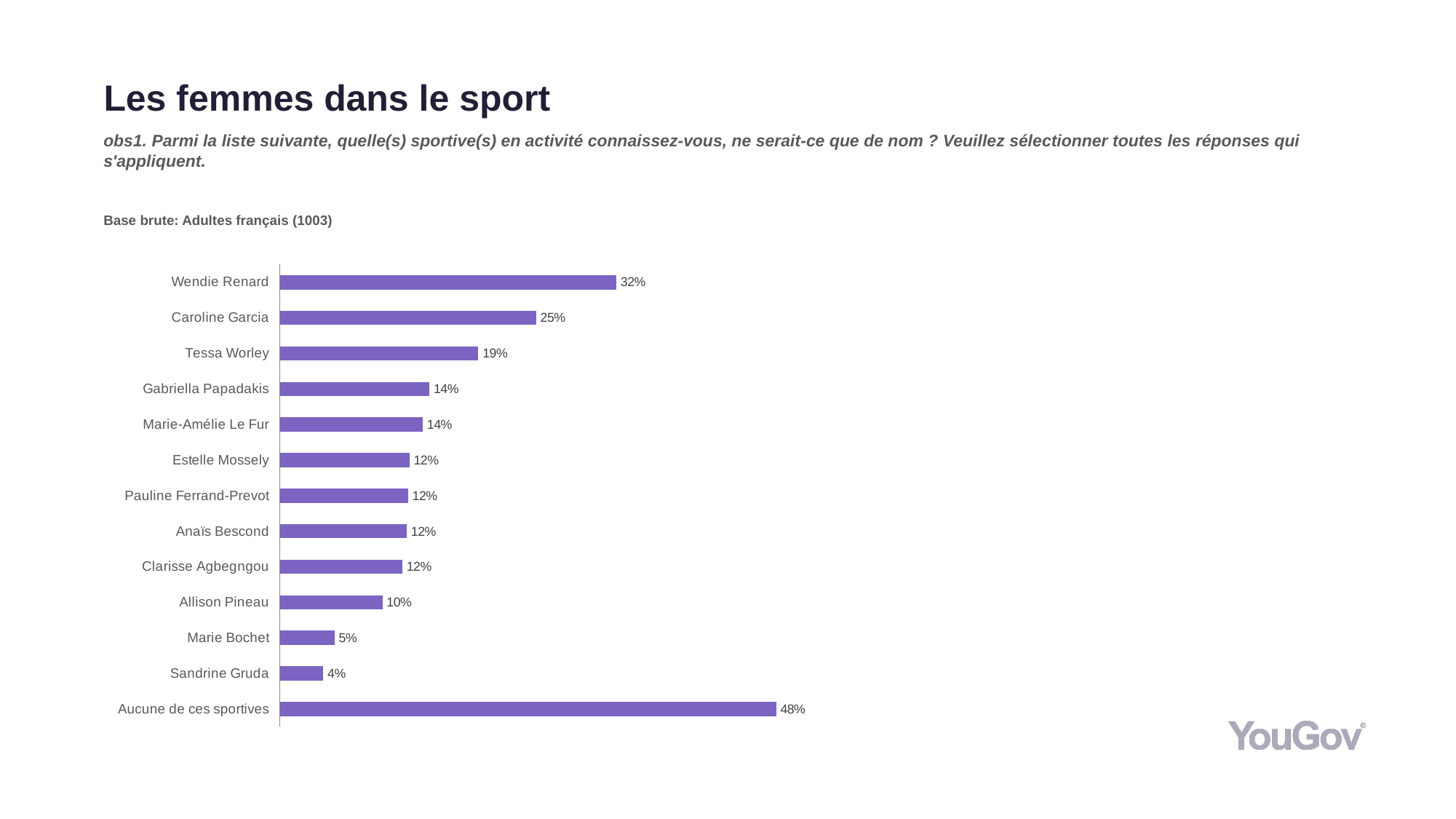
How many categories are shown in the chart? 13 Which category has the lowest value? Sandrine Gruda What kind of chart is shown on the slide? Bar chart Which category has the highest value? Aucune de ces sportives What is the difference between the values for Wendie Renard and Caroline Garcia? 7% What is the value for Aucune de ces sportives? 48% What is the value for Wendie Renard? 32% What is the value for Tessa Worley? 19% Which is larger, the value for Marie Bochet or the value for Sandrine Gruda? Marie Bochet What is the title of the slide? Les femmes dans le sport What is the value for Caroline Garcia? 25% What is the value for Allison Pineau? 10%